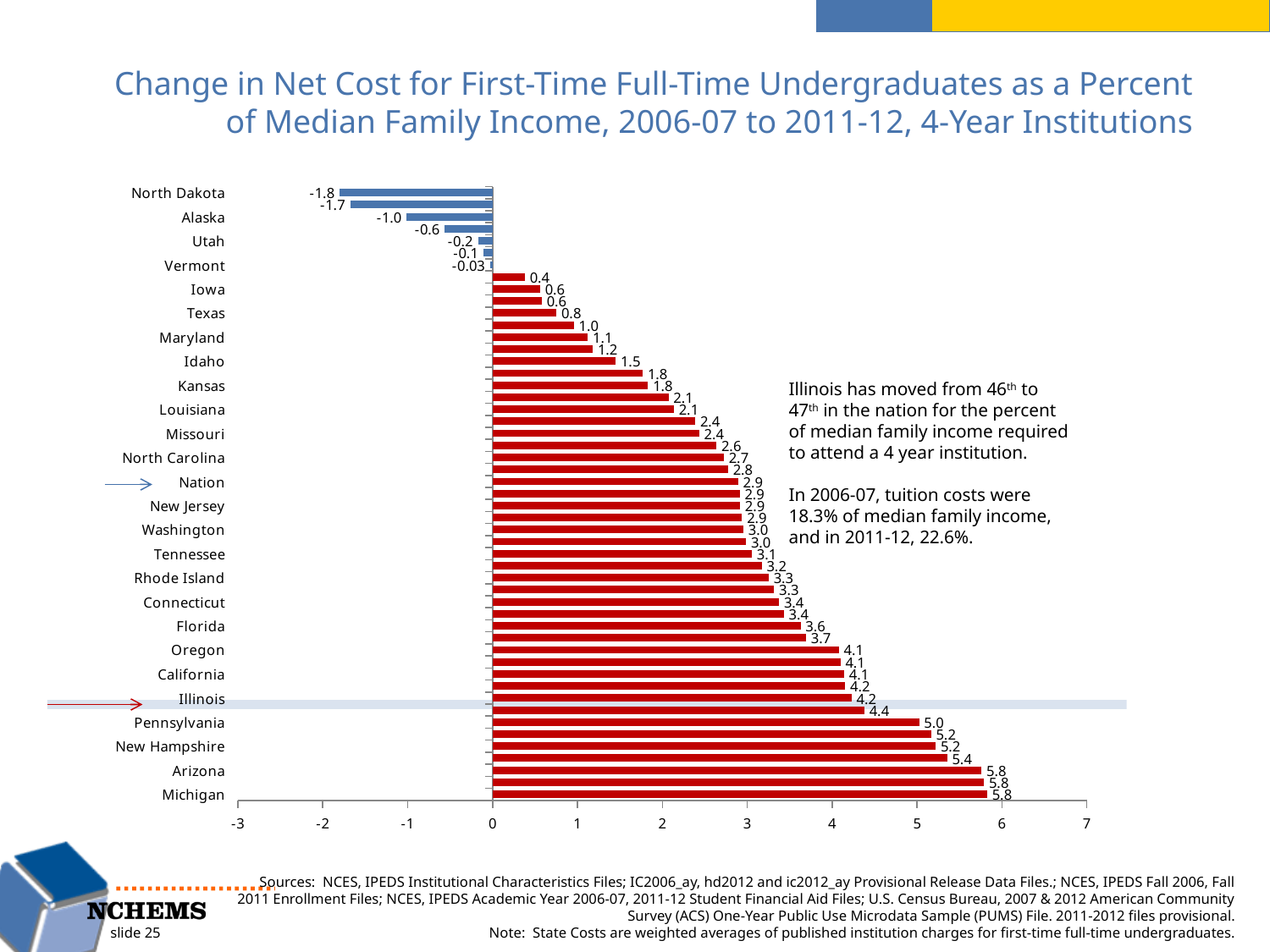
Which state's row is highlighted with a shaded band and an arrow on the chart? Illinois What is the difference between the value for Illinois and the value for Nation? 1.3 What is the value for North Dakota? -1.8 What is the value for Florida? 3.6 Which is larger, the value for Illinois or the value for Nation? Illinois Do the bar values increase or decrease going from the top of the chart to the bottom? increase Is the value for Arizona greater or less than 5? greater What is the value for Michigan? 5.8 What type of chart is shown on the slide? bar chart What is the value for Pennsylvania? 5.0 What is the value for Nation? 2.9 What is the value for Illinois? 4.2